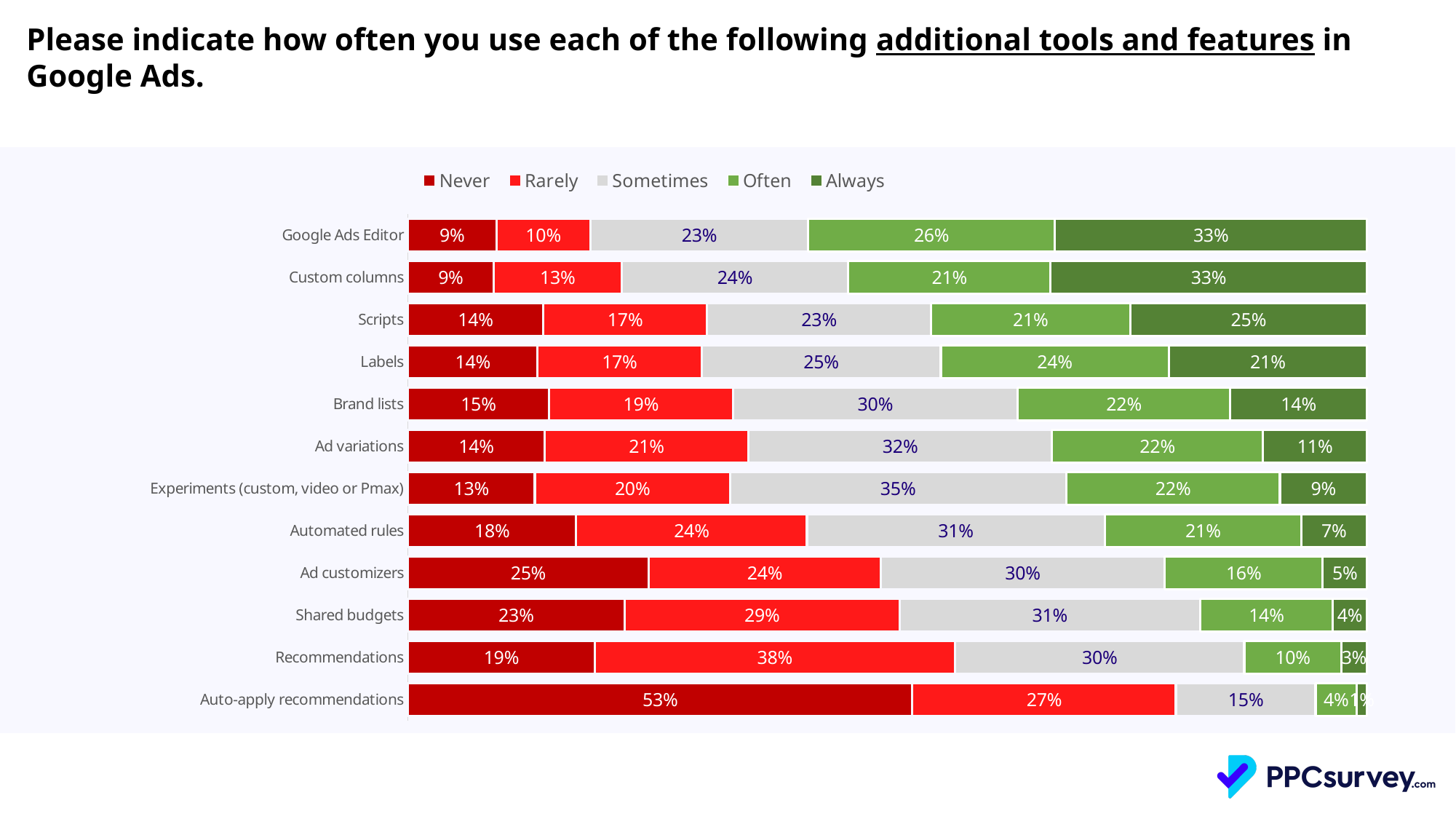
What is the 'Sometimes' value for Experiments (custom, video or Pmax)? 35% Which legend entry is shown in grey? Sometimes What is the difference between the 'Always' values for Google Ads Editor and Scripts? 8% What percentage of respondents say they 'Always' use Google Ads Editor? 33% What percentage of respondents say they 'Never' use Auto-apply recommendations? 53% What kind of chart is shown on the slide? Stacked bar chart How many series does the legend list? 5 Which tool has the highest 'Never' percentage? Auto-apply recommendations Which has a larger 'Often' value, Labels or Brand lists? Labels Which tool has the lowest 'Always' percentage? Auto-apply recommendations How many tools or features are listed in the chart? 12 What is the 'Rarely' value for Recommendations? 38%